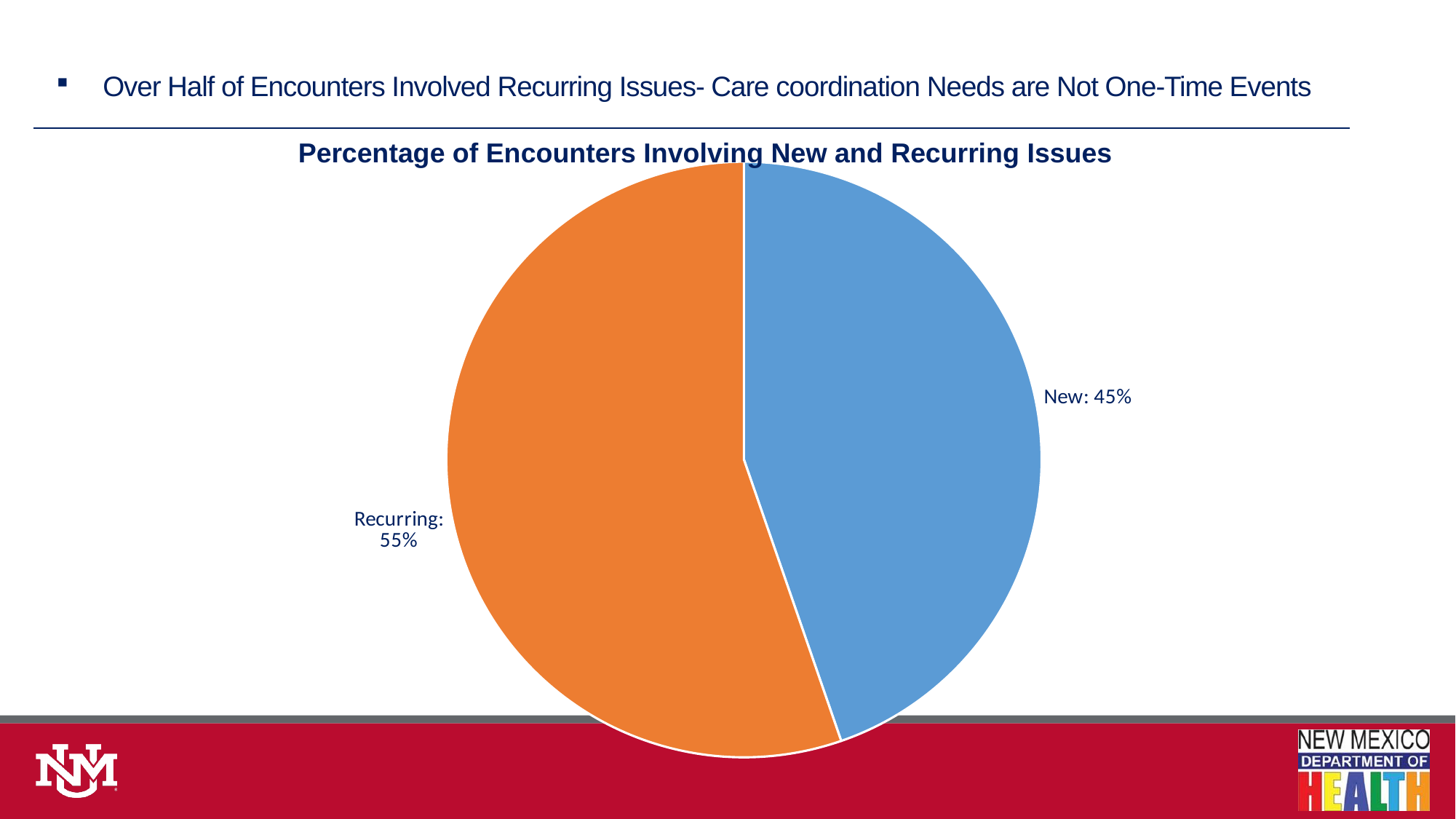
Which is larger, the share for New or the share for Recurring? Recurring What kind of chart is shown on the slide? pie chart What is the title of the chart? Percentage of Encounters Involving New and Recurring Issues What percentage of encounters involved new issues? 45% Which category has the smallest share of the pie? New Which category has the largest share of the pie? Recurring What share of the pie does the New slice represent? 45% How many slices does the pie chart have? 2 What colour is the Recurring slice? orange What is the difference in percentage points between the Recurring and New slices? 10 What percentage of encounters involved recurring issues? 55%